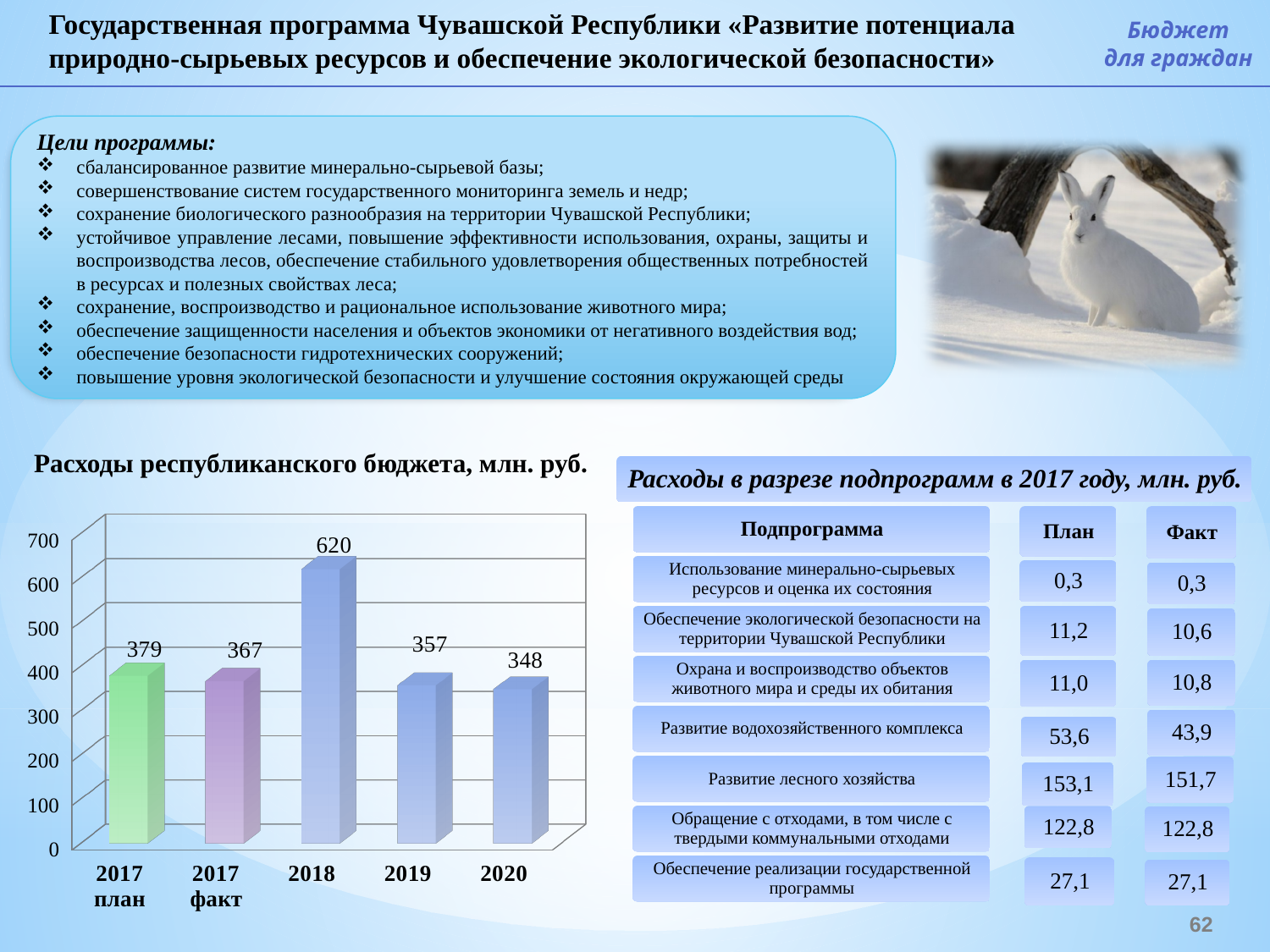
What is the difference between the values for 2018 and 2019 in the chart "Расходы республиканского бюджета, млн. руб."? 263 How many bars are shown in the chart "Расходы республиканского бюджета, млн. руб."? 5 What is the value for 2018 in the chart "Расходы республиканского бюджета, млн. руб."? 620 Which is larger in the chart "Расходы республиканского бюджета, млн. руб.": the value for 2019 or the value for 2020? 2019 What is the value for 2017 план in the chart "Расходы республиканского бюджета, млн. руб."? 379 What is the difference between the values for 2017 план and 2017 факт in the chart "Расходы республиканского бюджета, млн. руб."? 12 Which category has the lowest value in the chart "Расходы республиканского бюджета, млн. руб."? 2020 Do the values rise or fall from 2018 to 2020 in the chart "Расходы республиканского бюджета, млн. руб."? fall What kind of chart is "Расходы республиканского бюджета, млн. руб."? bar chart What is the value for 2020 in the chart "Расходы республиканского бюджета, млн. руб."? 348 Is the value for 2018 greater or less than 600 in the chart "Расходы республиканского бюджета, млн. руб."? greater Which category has the highest value in the chart "Расходы республиканского бюджета, млн. руб."? 2018